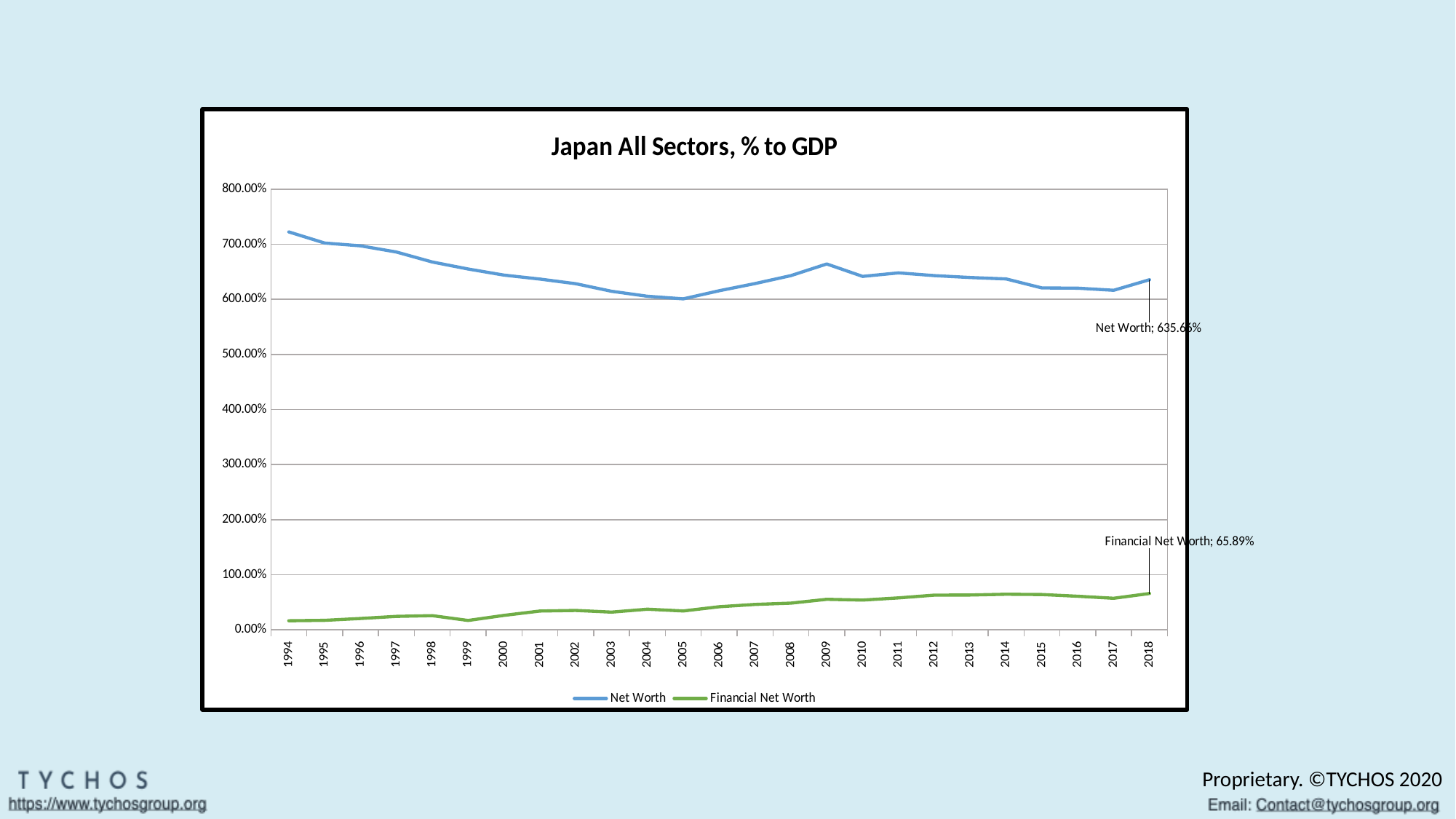
What is the Financial Net Worth value for 2018? 65.89% Is the Net Worth value for 1994 greater or less than 700.00%? greater What kind of chart is shown on the slide? line chart What is the title of the chart? Japan All Sectors, % to GDP Does Net Worth rise or fall from 1994 to 2005? fall Which series has the larger value in 2010, Net Worth or Financial Net Worth? Net Worth Does Financial Net Worth rise or fall overall from 1994 to 2018? rise How many years are plotted along the x axis? 25 Is the Financial Net Worth value for 2009 greater or less than 100.00%? less How many series does the legend list? 2 Is the Net Worth value for 2005 greater or less than 650.00%? less In which year is Net Worth at its highest? 1994